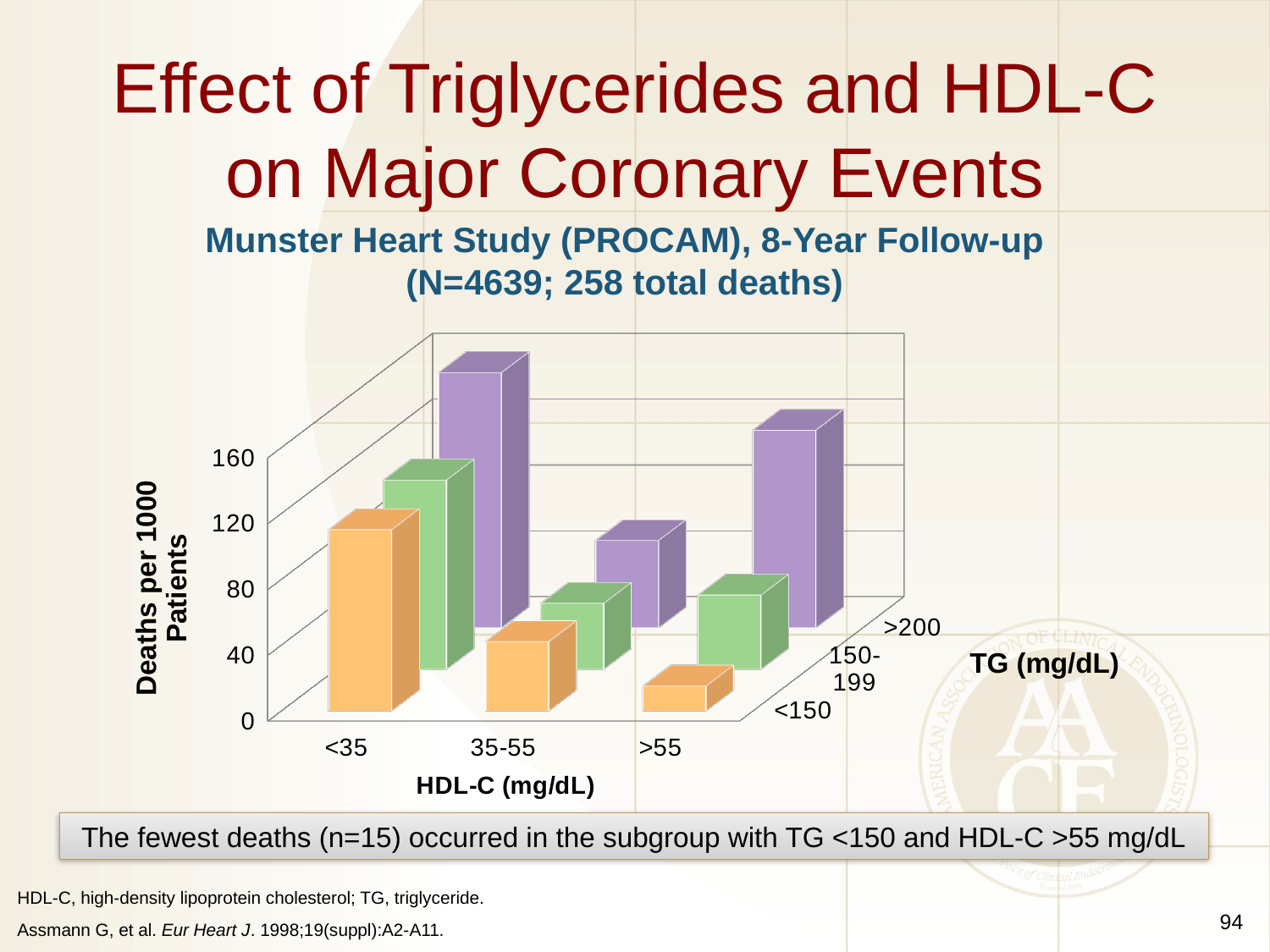
Within the HDL-C <35 group, which has more deaths per 1000 patients: TG <150 or TG >200? TG >200 How many HDL-C categories are shown on the x axis? 3 Is the value for HDL-C <35 with TG <150 greater or less than 80? greater For the TG <150 group, do deaths per 1000 patients rise or fall as HDL-C increases from <35 to >55? fall Which combination of HDL-C and TG has the lowest deaths per 1000 patients? HDL-C >55, TG <150 Is the value for HDL-C 35-55 with TG <150 greater or less than 80? less Which combination of HDL-C and TG has the highest deaths per 1000 patients? HDL-C <35, TG >200 Is the value for HDL-C >55 with TG <150 greater or less than 40? less What kind of chart is shown on the slide? bar chart How many TG (mg/dL) groups are plotted in the chart? 3